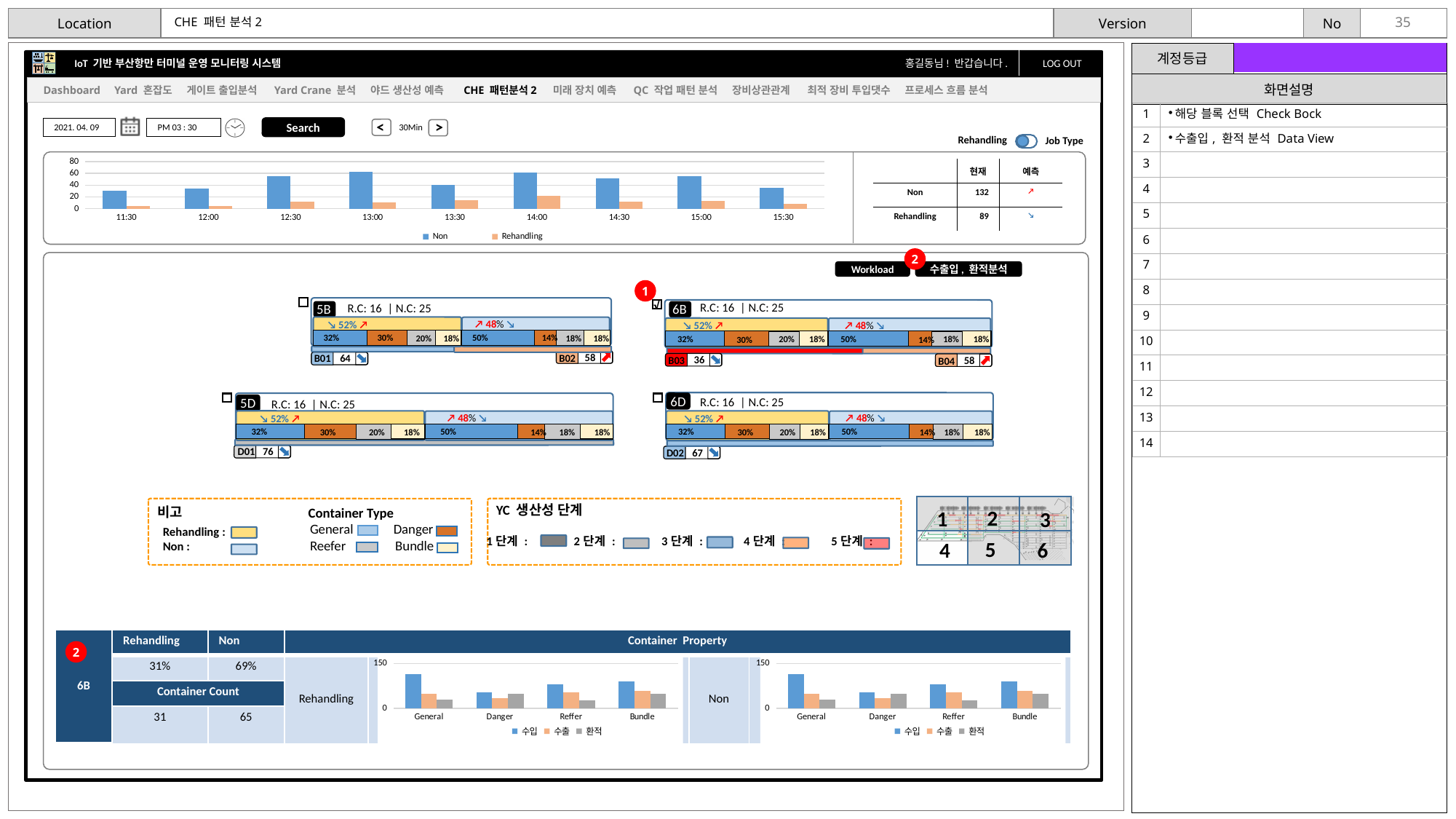
In the Rehandling Container Property chart at the bottom, which category has the tallest 수입 bar? General In the top time-series chart, which is larger at 12:30, the Non value or the Rehandling value? Non How many series does the legend of the Non Container Property chart at the bottom list? 3 In the top time-series chart, is the Non value at 13:00 greater or less than 40? greater How many series does the legend of the top time-series chart list? 2 How many time points are shown on the x axis of the top time-series chart? 9 In the top time-series chart, which is larger for Non, the value at 13:00 or the value at 13:30? 13:00 In the top time-series chart, at which time is the Rehandling value highest? 14:00 What kind of chart is the chart at the top of the dashboard showing values from 11:30 to 15:30? bar chart In the Rehandling Container Property chart at the bottom, how many container type categories are shown on the x axis? 4 In the top time-series chart, is the Non value at 11:30 greater or less than 40? less In the top time-series chart, is the Rehandling value at 14:00 greater or less than 40? less